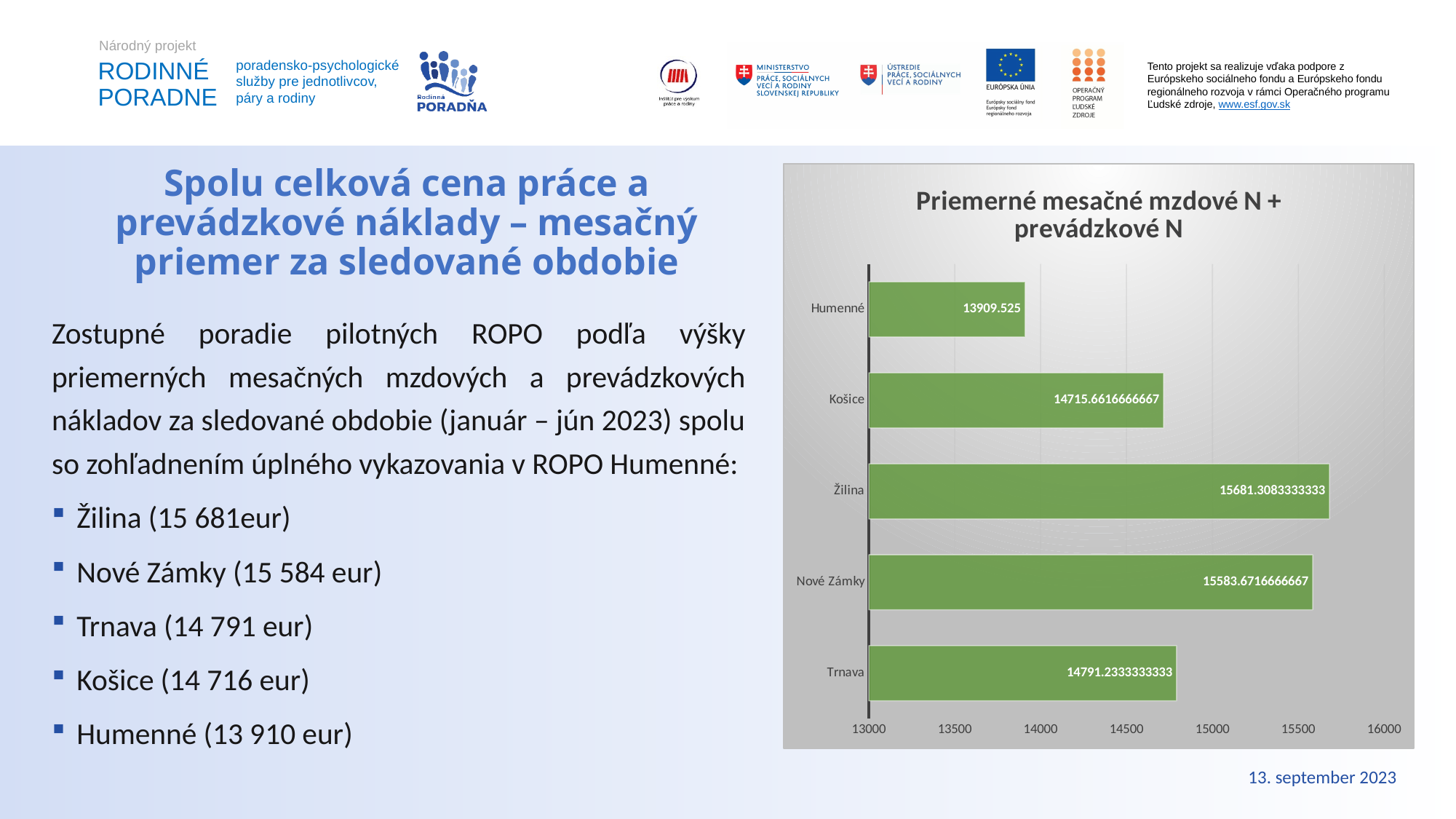
How many categories are shown in the chart? 5 Which is larger, the value for Košice or the value for Nové Zámky? Nové Zámky What is the value for Trnava? 14791.2333333333 What is the value for Košice? 14715.6616666667 What type of chart is shown on the slide? bar chart Is the value for Humenné greater or less than 14000? less Which category has the highest value? Žilina What is the value for Humenné? 13909.525 What is the value for Nové Zámky? 15583.6716666667 What is the value for Žilina? 15681.3083333333 What is the title of the chart? Priemerné mesačné mzdové N + prevádzkové N Which category has the lowest value? Humenné